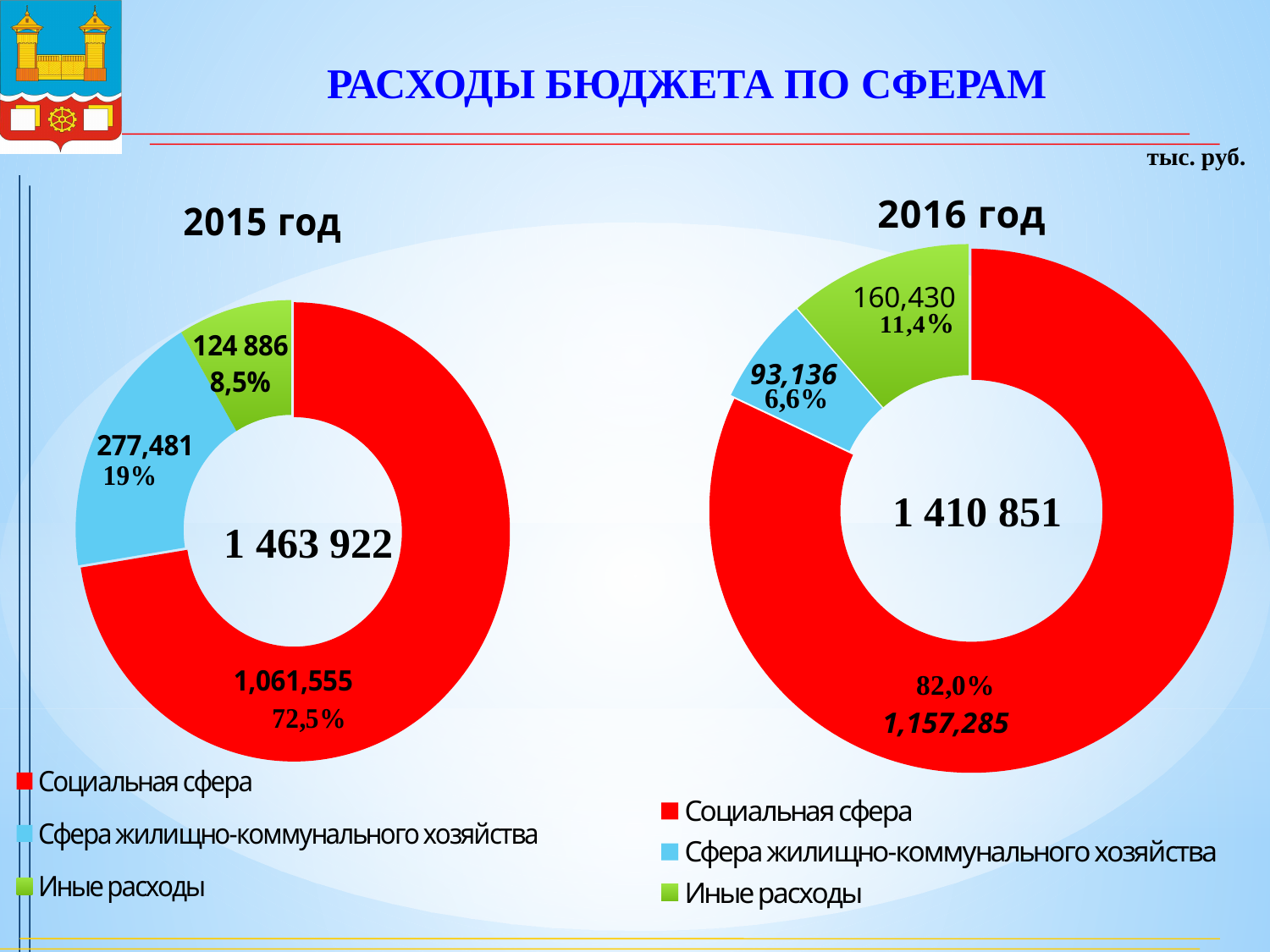
How many categories does the legend of the 2016 год chart list? 3 In the 2016 год chart, what share does Иные расходы have? 11,4% In the 2016 год chart, which category is the smallest? Сфера жилищно-коммунального хозяйства What is the title of the slide? РАСХОДЫ БЮДЖЕТА ПО СФЕРАМ What type of chart is used for the 2015 год chart? Doughnut (pie) chart Which is larger: Иные расходы in the 2015 год chart or Иные расходы in the 2016 год chart? 2016 год In the 2016 год chart, which category is the largest? Социальная сфера In the 2015 год chart, what is the value for Социальная сфера? 1,061,555 In the 2015 год chart, what is the value for Иные расходы? 124 886 What total is shown in the centre of the 2015 год chart? 1 463 922 In the 2015 год chart, what share does Сфера жилищно-коммунального хозяйства have? 19% In the 2016 год chart, what is the value for Сфера жилищно-коммунального хозяйства? 93,136